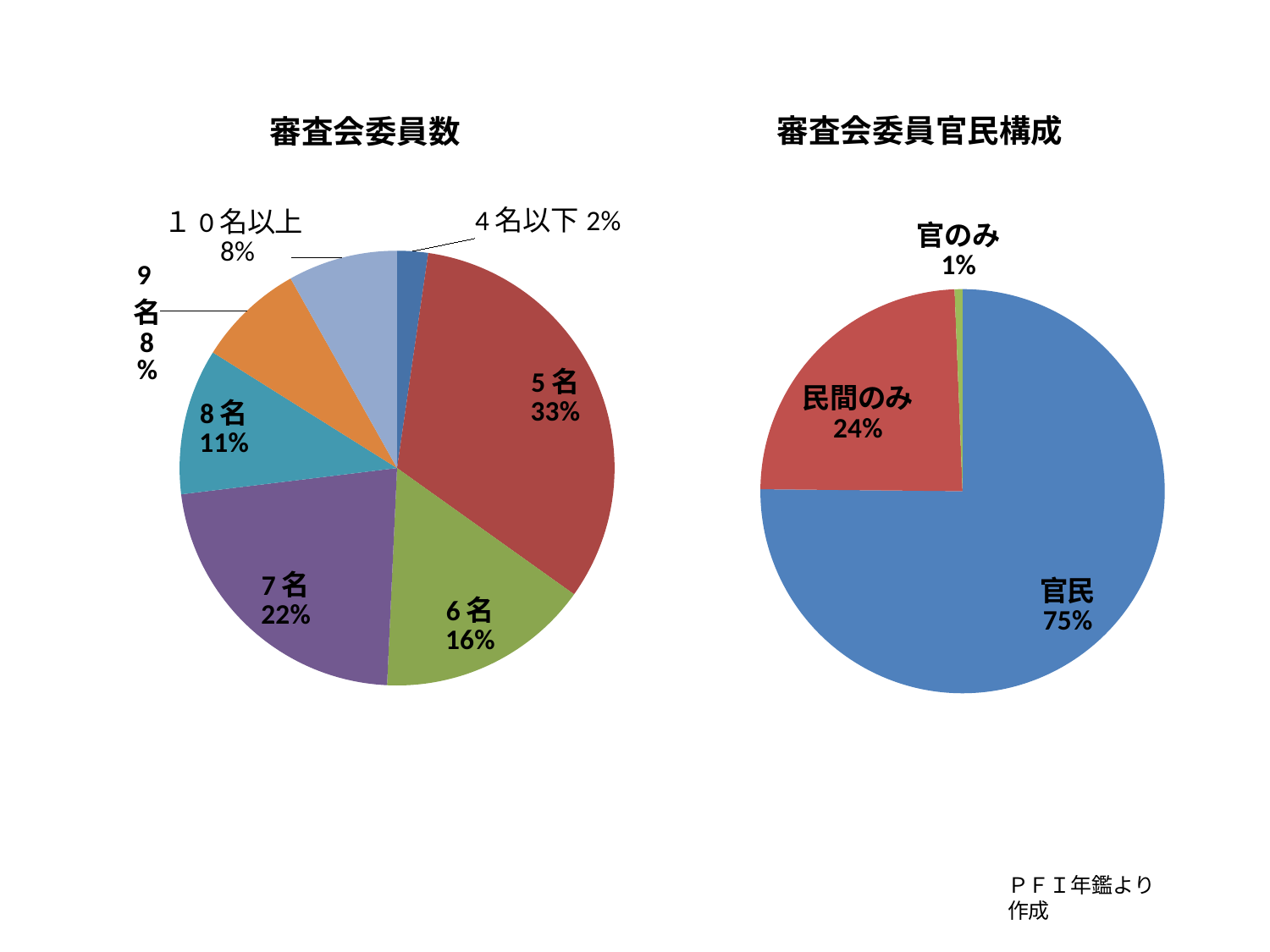
What kind of chart is the 審査会委員数 chart? Pie chart In the 審査会委員数 chart, which category has the largest share? 5名 In the 審査会委員官民構成 chart, which category has the smallest share? 官のみ How many categories are shown in the 審査会委員官民構成 chart? 3 In the 審査会委員数 chart, which category has the smallest share? 4名以下 In the 審査会委員官民構成 chart, what share does 官民 have? 75% In the 審査会委員数 chart, which is larger, the share of 8名 or the share of 6名? 6名 In the 審査会委員数 chart, what share does 5名 have? 33% In the 審査会委員官民構成 chart, what share does 民間のみ have? 24% In the 審査会委員数 chart, what is the difference between the shares of 5名 and 6名? 17% In the 審査会委員数 chart, what share does 7名 have? 22% How many categories are shown in the 審査会委員数 chart? 7